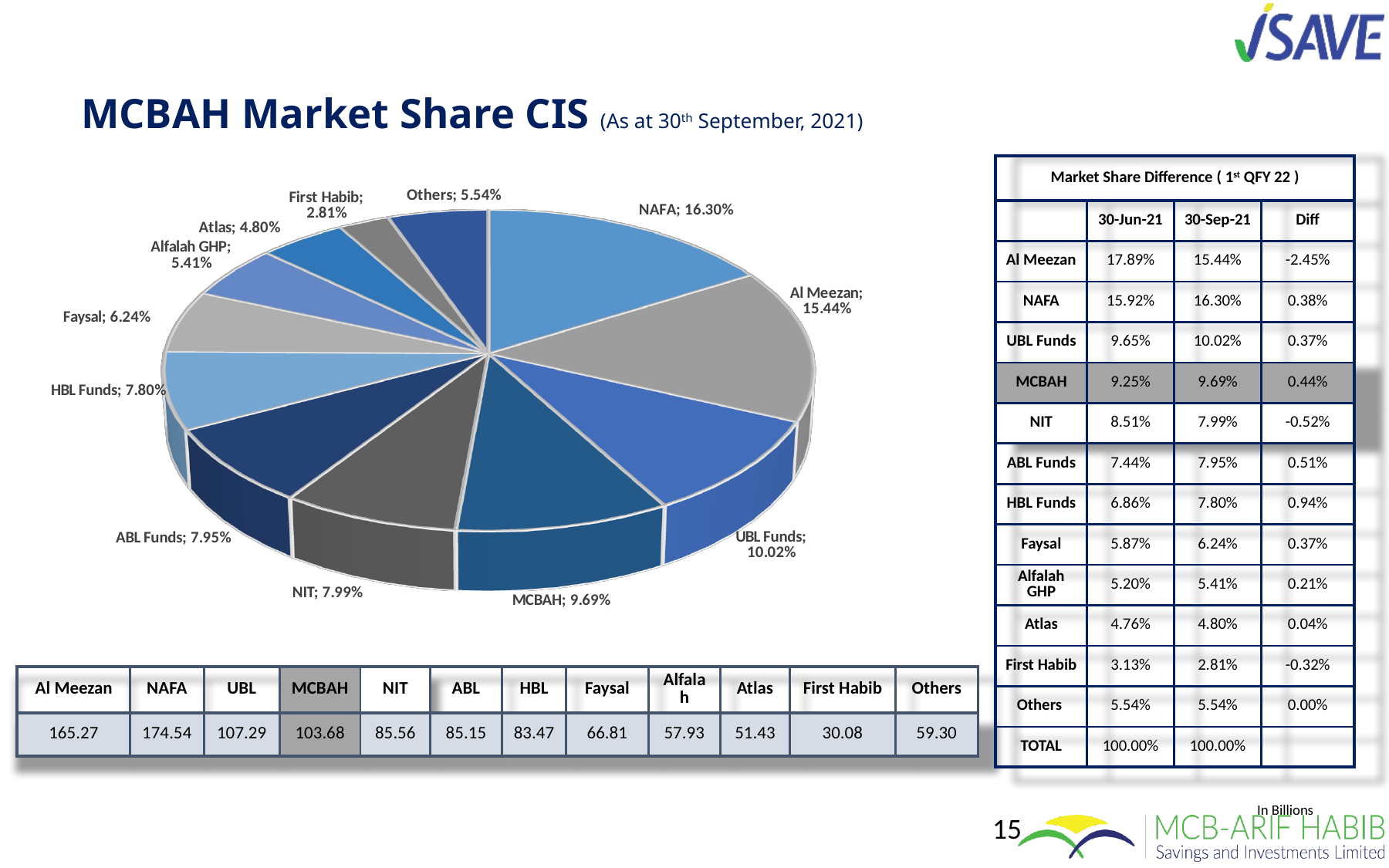
What is the difference between the MCBAH and NIT shares in the pie chart? 1.70% What kind of chart is shown on the slide? pie chart Which slice of the pie chart is the smallest? First Habib What is the value shown for HBL Funds in the pie chart? 7.80% What is the difference between the NAFA and Al Meezan shares in the pie chart? 0.86% Which slice of the pie chart is the largest? NAFA What share of the pie does MCBAH hold? 9.69% How many slices does the pie chart have? 12 Which has a larger share in the pie chart, UBL Funds or MCBAH? UBL Funds What is the value shown for Alfalah GHP in the pie chart? 5.41% Which has a larger share in the pie chart, Faysal or Atlas? Faysal What is the value shown for NAFA in the pie chart? 16.30%